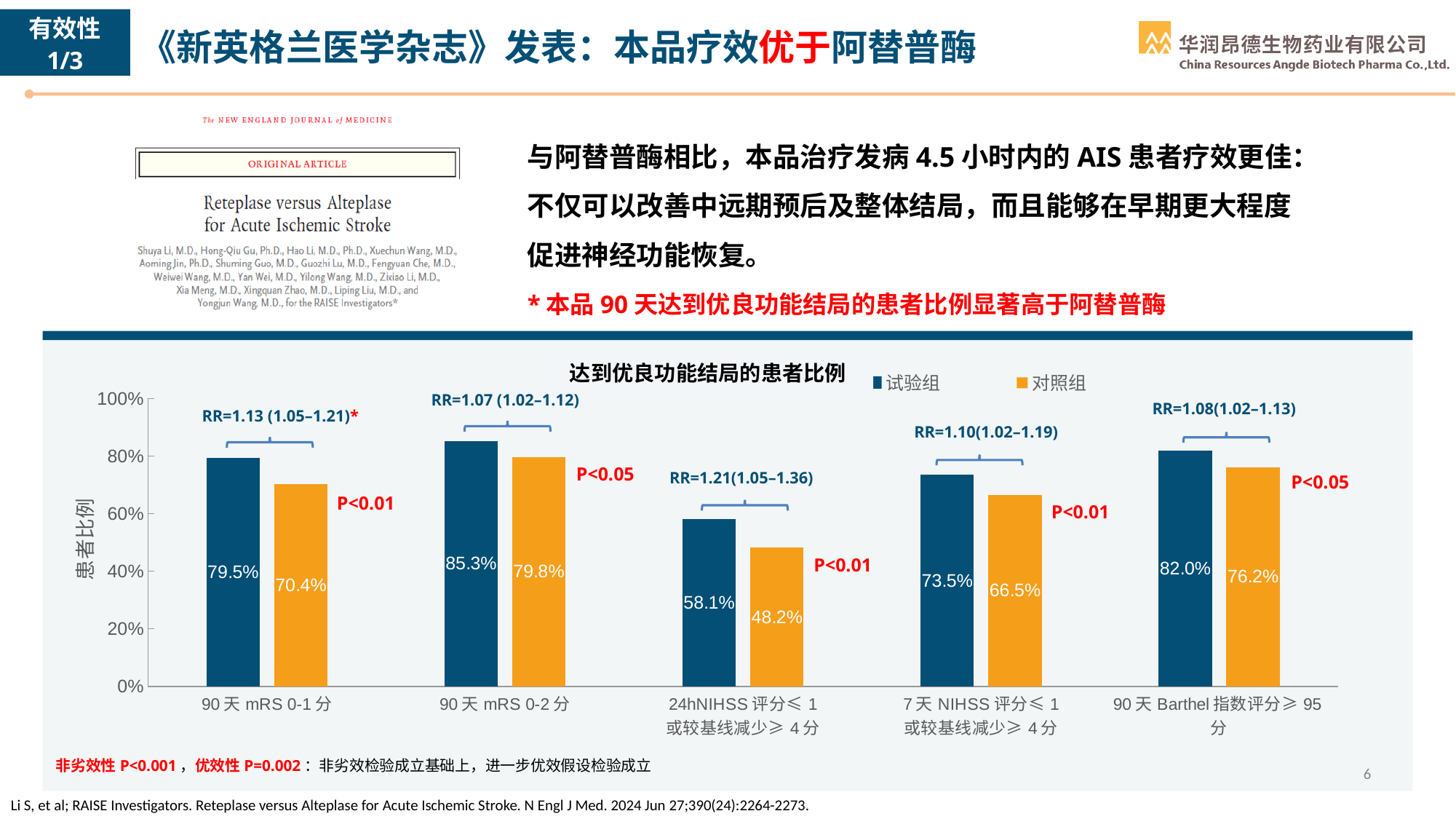
What is the value for 试验组 in the 90 天 Barthel 指数评分≥95 分 category? 82.0% What is the value for 对照组 in the 90 天 mRS 0-2 分 category? 79.8% Which is larger in the 90 天 mRS 0-1 分 category: the 试验组 value or the 对照组 value? 试验组 How many series does the legend list? 2 In which category is the 对照组 value lowest? 24hNIHSS 评分≤1 或较基线减少≥4 分 In which category is the 试验组 value highest? 90 天 mRS 0-2 分 What is the difference between the 试验组 and 对照组 values in the 7 天 NIHSS 评分≤1 或较基线减少≥4 分 category? 7.0% What type of chart is shown on the slide? bar chart What is the value for 对照组 in the 24hNIHSS 评分≤1 或较基线减少≥4 分 category? 48.2% What is the value for 试验组 in the 90 天 mRS 0-1 分 category? 79.5% How many categories are shown on the x axis? 5 What is the title of the chart? 达到优良功能结局的患者比例